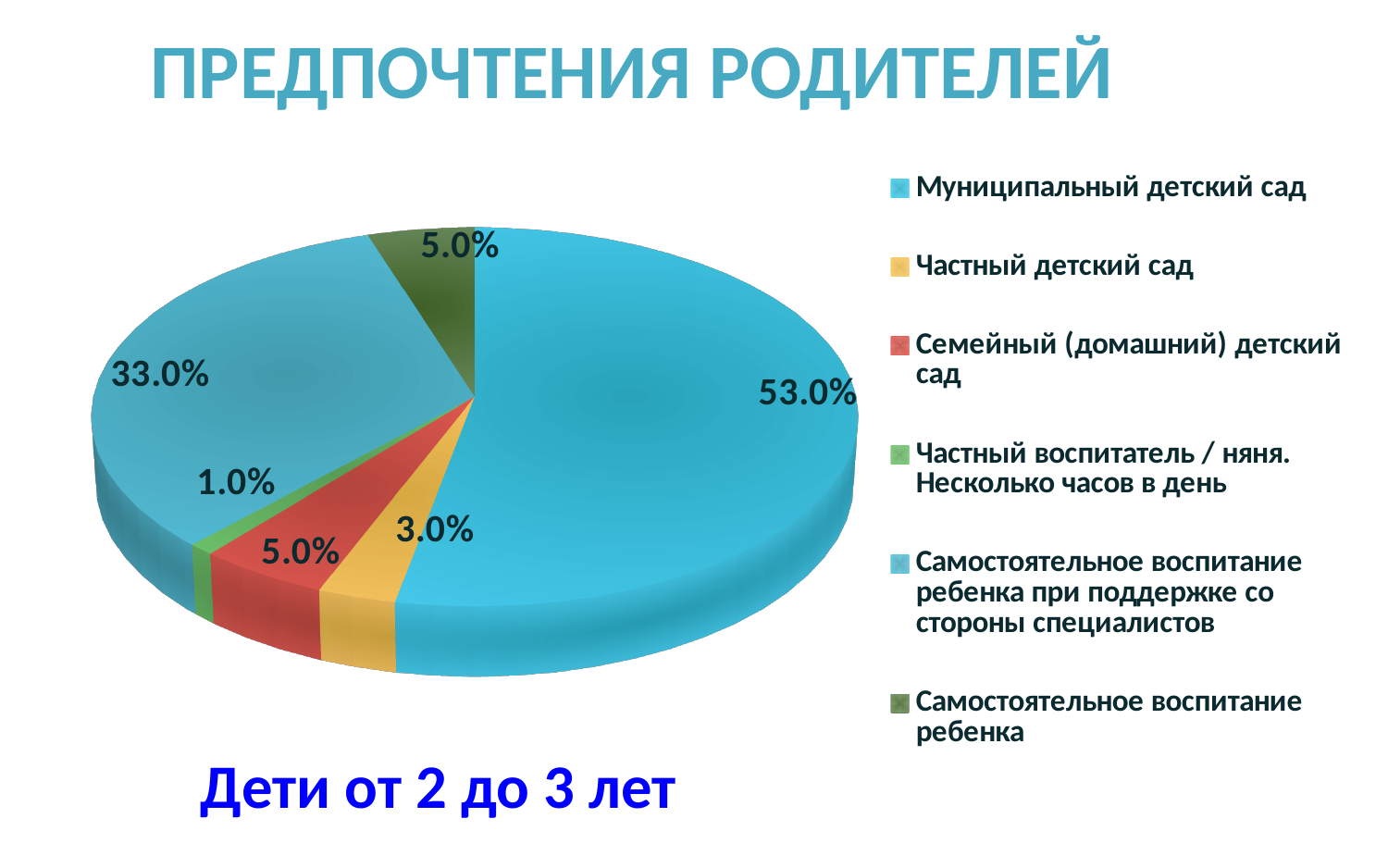
What value is shown for "Семейный (домашний) детский сад"? 5.0% What type of chart is shown on the slide? pie chart What share of the pie does "Муниципальный детский сад" have? 53.0% What value is shown for "Частный детский сад"? 3.0% Which category has the largest share of the pie? Муниципальный детский сад Which is larger: the share for "Семейный (домашний) детский сад" or the share for "Частный детский сад"? Семейный (домашний) детский сад Which category has the smallest share of the pie? Частный воспитатель / няня. Несколько часов в день What value is shown for "Частный воспитатель / няня. Несколько часов в день"? 1.0% What is the title of the slide above the chart? ПРЕДПОЧТЕНИЯ РОДИТЕЛЕЙ What is the difference between the shares of "Муниципальный детский сад" and "Самостоятельное воспитание ребенка при поддержке со стороны специалистов"? 20.0% What share of the pie does "Самостоятельное воспитание ребенка при поддержке со стороны специалистов" have? 33.0% How many slices does the pie chart have? 6